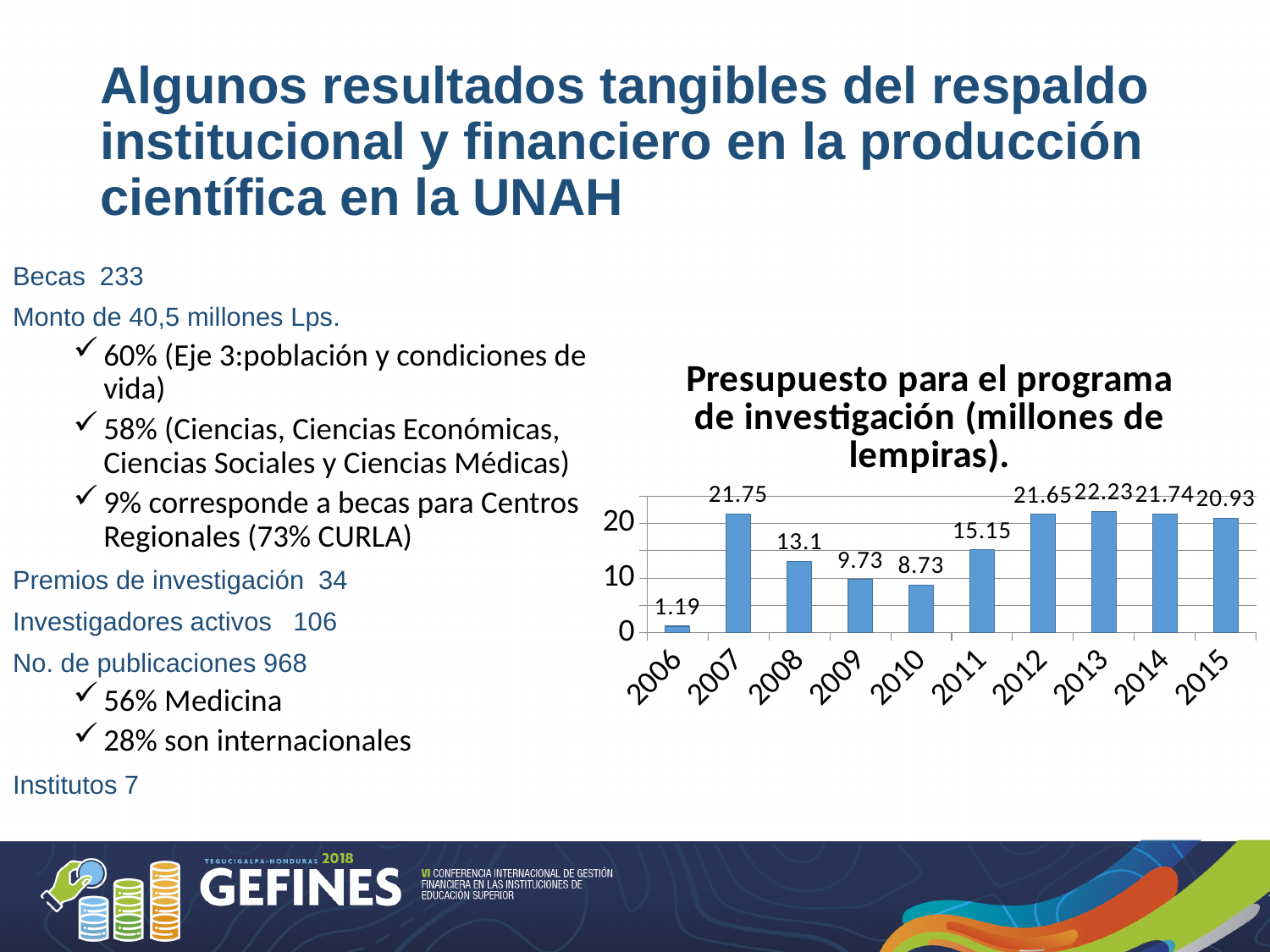
What is the budget value shown for 2008? 13.1 What is the budget value shown for 2015? 20.93 Is the value for 2010 greater or less than 10? less Which year has a larger budget value, 2009 or 2011? 2011 What kind of chart is used to show the research programme budget? bar chart What is the difference between the budget values for 2007 and 2006? 20.56 How many years are shown on the x axis of the chart? 10 Which year has the lowest budget value? 2006 What is the title of the chart? Presupuesto para el programa de investigación (millones de lempiras). What is the difference between the budget values for 2013 and 2010? 13.5 What is the budget value shown for 2011? 15.15 Which year has the highest budget value? 2013